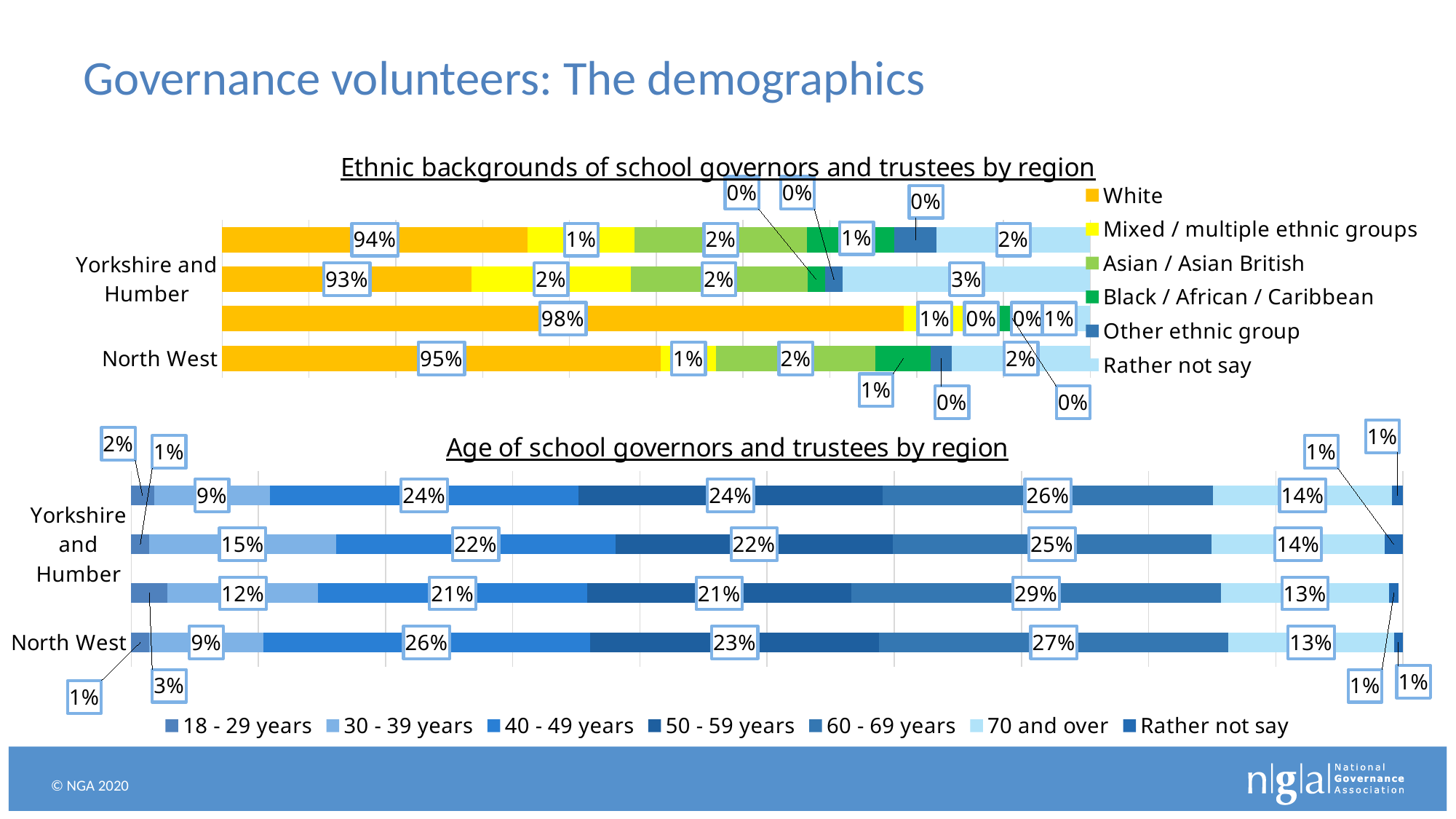
In the 'Age of school governors and trustees by region' chart, what percentage of governors and trustees in Yorkshire and Humber are aged 30 - 39 years? 15% What is the title of the top chart on the slide? Ethnic backgrounds of school governors and trustees by region What type of chart is the 'Age of school governors and trustees by region' chart? Stacked bar chart In the 'Ethnic backgrounds of school governors and trustees by region' chart, is the White share higher in the North West or in Yorkshire and Humber? North West In the 'Ethnic backgrounds of school governors and trustees by region' chart, what is the 'Rather not say' value for Yorkshire and Humber? 3% In the 'Age of school governors and trustees by region' chart, what is the '70 and over' value for the North West? 13% In the 'Age of school governors and trustees by region' chart, how many percentage points higher is the 40 - 49 years share in the North West than in Yorkshire and Humber? 4 percentage points How many series does the legend of the 'Ethnic backgrounds of school governors and trustees by region' chart list? 6 In the 'Age of school governors and trustees by region' chart, which age group has the largest share in the North West? 60 - 69 years In the 'Age of school governors and trustees by region' chart, what percentage of governors and trustees in the North West are aged 60 - 69 years? 27% In the 'Ethnic backgrounds of school governors and trustees by region' chart, what percentage of governors and trustees in the North West are White? 95% How many series does the legend of the 'Age of school governors and trustees by region' chart list? 7